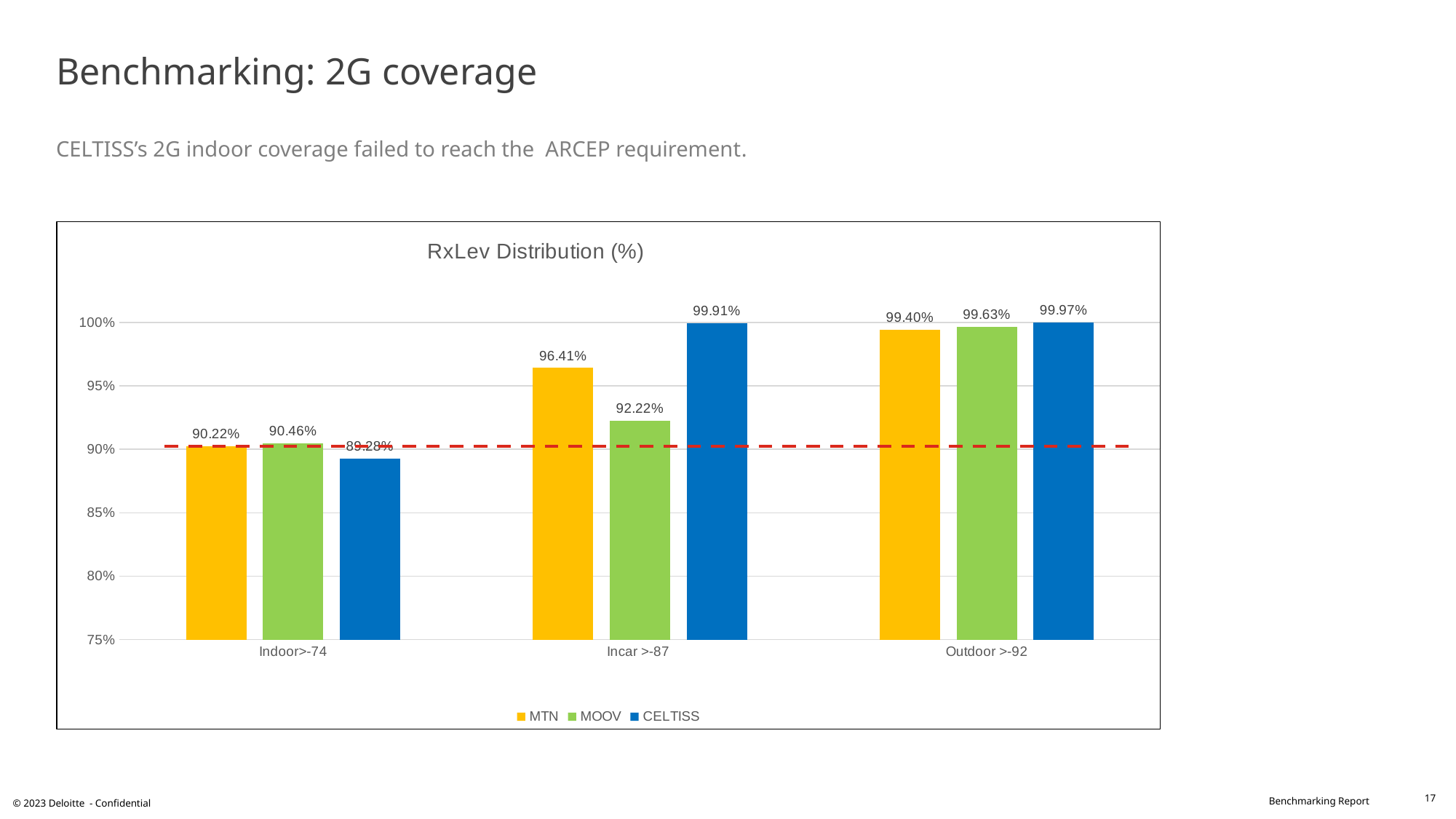
How many categories are shown on the x axis? 3 What is the value for MTN in the Incar >-87 category? 96.41% What is the difference between the MTN and MOOV values in the Incar >-87 category? 4.19% Which is larger: the MOOV value for Incar >-87 or the MTN value for Incar >-87? MTN value for Incar >-87 What is the value for MOOV in the Outdoor >-92 category? 99.63% What kind of chart is shown on the slide? Bar chart What is the title of the chart? RxLev Distribution (%) Which operator has the highest value in the Incar >-87 category? CELTISS How many series does the legend list? 3 Is the value for CELTISS in the Indoor>-74 category greater or less than 90%? less Which operator has the lowest value in the Indoor>-74 category? CELTISS What is the value for CELTISS in the Indoor>-74 category? 89.28%